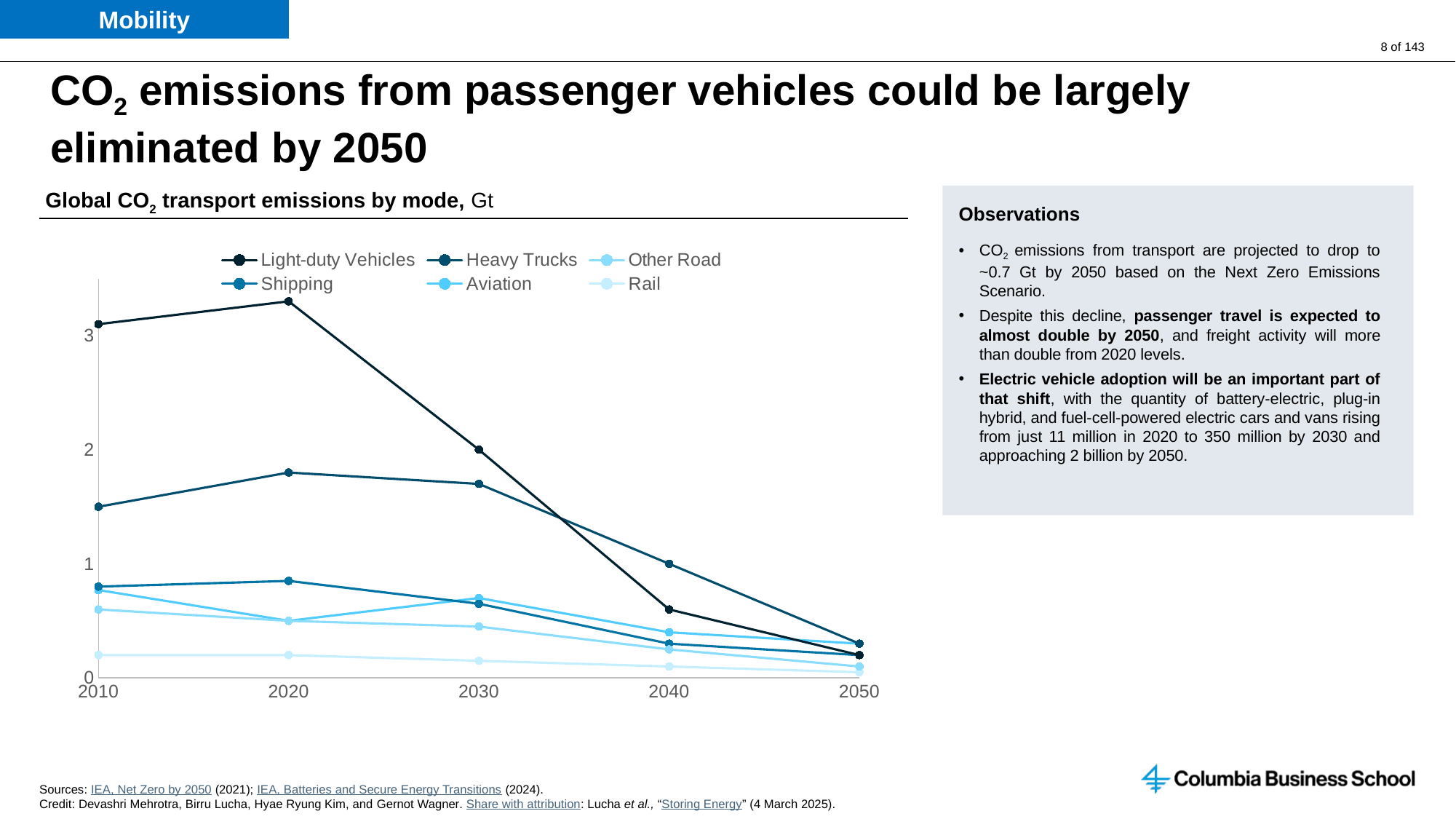
Which series has the highest value in 2020? Light-duty Vehicles What kind of chart is shown on the slide? line chart Is the value for Light-duty Vehicles in 2040 greater or less than 1? less In 2010, which is larger: Light-duty Vehicles or Heavy Trucks? Light-duty Vehicles How many series does the legend list? 6 How many years are plotted along the x axis? 5 Do the values for Light-duty Vehicles rise or fall from 2020 to 2050? fall Is the value for Heavy Trucks in 2030 greater or less than 1? greater Is the value for Light-duty Vehicles in 2020 greater or less than 3? greater What unit is given in the chart title? Gt Which series has the lowest value in 2010? Rail